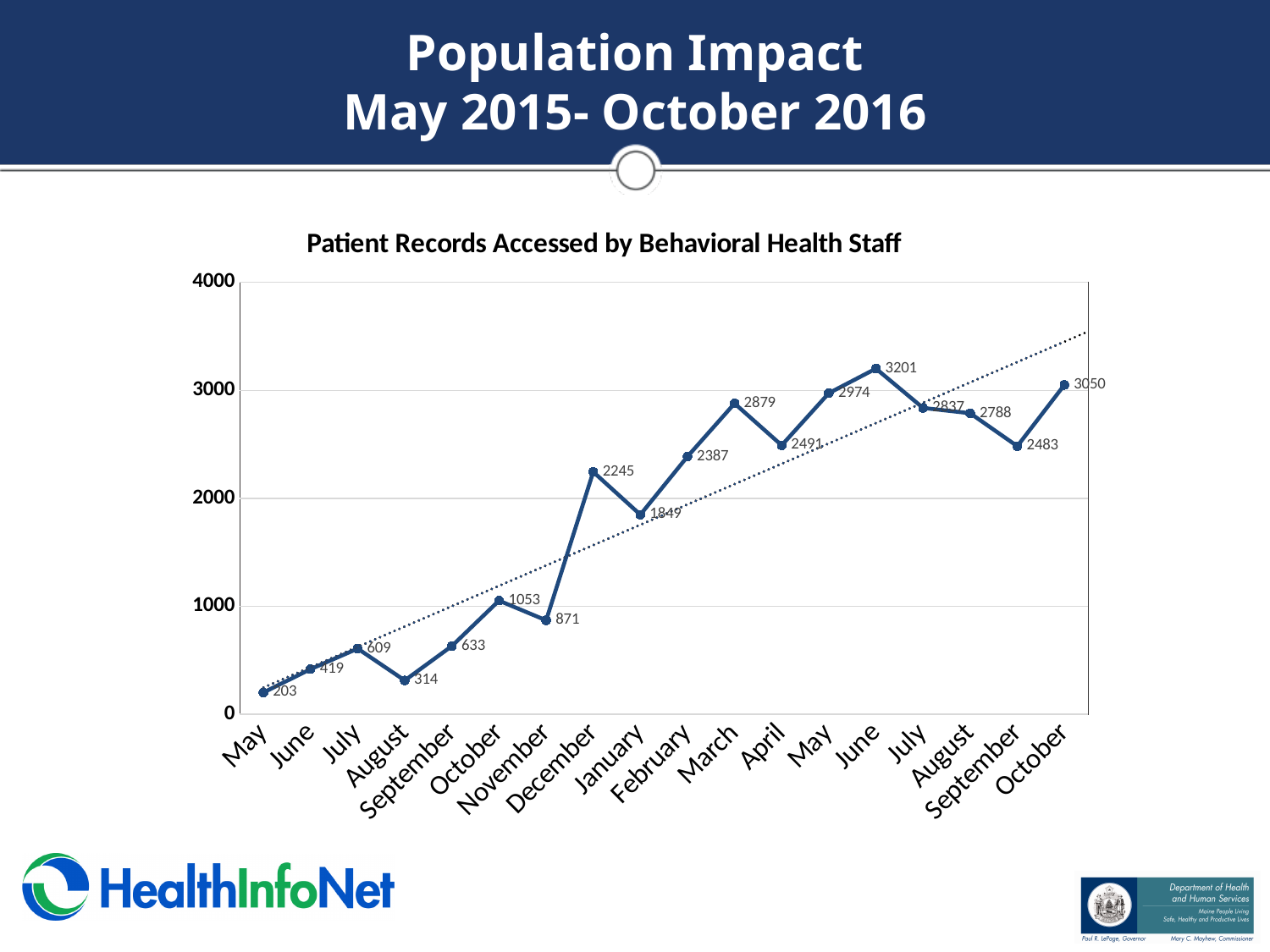
What is the title of the chart? Patient Records Accessed by Behavioral Health Staff What is the value for the last October on the chart (October 2016)? 3050 How many patient records were accessed in December? 2245 Do the values generally rise or fall from May 2015 to October 2016? Rise Which month has the highest number of patient records accessed? June (2016), 3201 What is the difference between the highest value (3201) and the value for the following month, July 2016 (2837)? 364 What is the value for the first May on the chart (May 2015)? 203 What is the difference between the December value and the November value? 1374 What type of chart is shown on the slide? Line chart Which month has the lowest number of patient records accessed? May (2015), 203 How many data points are plotted on the line? 18 Which is larger, the value for March or the value for April? March